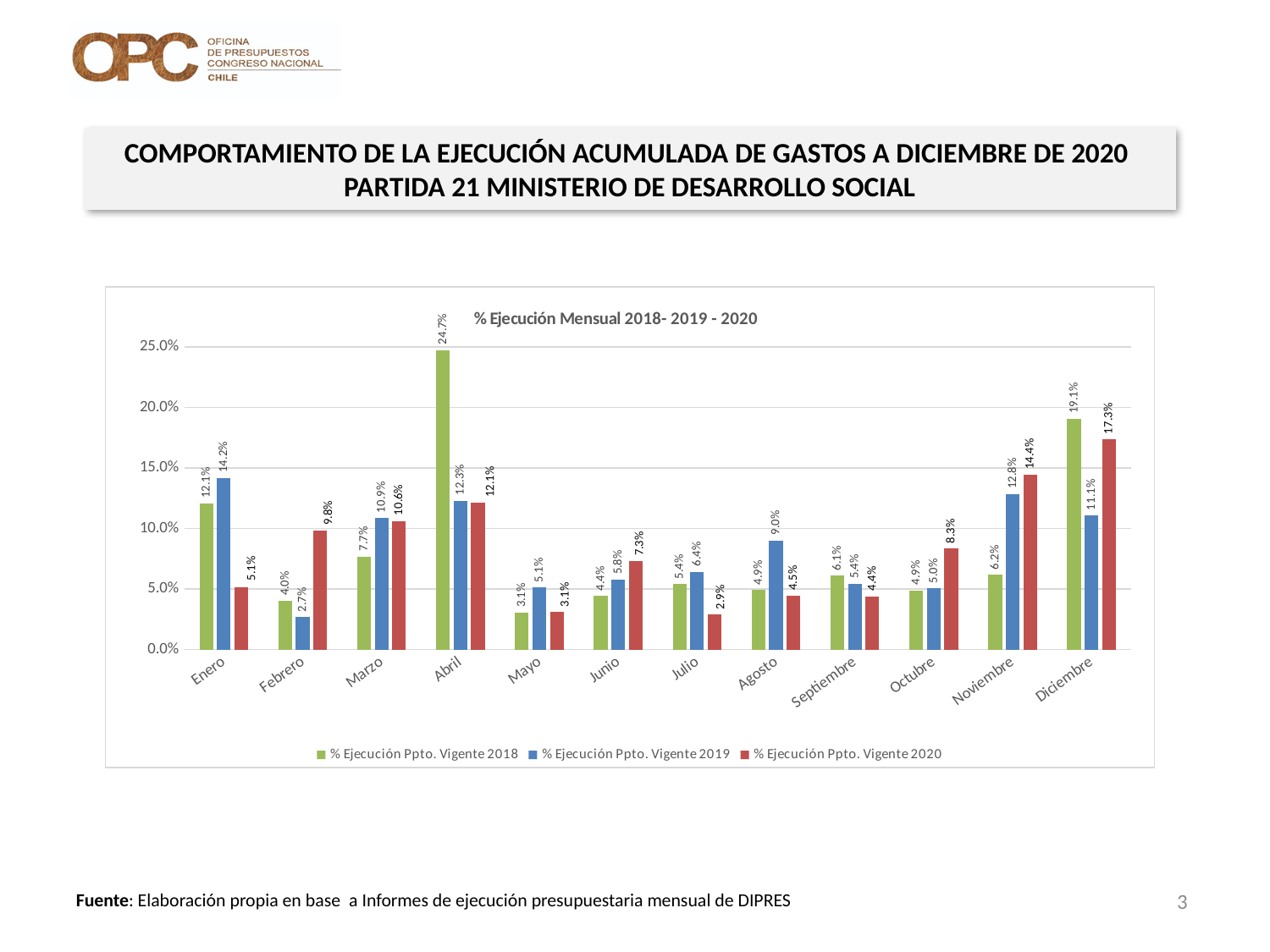
What is the value for % Ejecución Ppto. Vigente 2019 in Noviembre? 12.8% What is the value for % Ejecución Ppto. Vigente 2020 in Diciembre? 17.3% In which month is the % Ejecución Ppto. Vigente 2020 series lowest? Julio Is the value for % Ejecución Ppto. Vigente 2018 in Diciembre greater or less than 15.0%? greater How many months are shown on the x axis? 12 In which month is the % Ejecución Ppto. Vigente 2018 series highest? Abril Which is larger in Enero: the 2019 value or the 2020 value? 2019 value (14.2%) What is the difference between the 2018 and 2019 values in Abril? 12.4% How many series does the legend list? 3 What is the value for % Ejecución Ppto. Vigente 2018 in Abril? 24.7% What is the value for % Ejecución Ppto. Vigente 2020 in Febrero? 9.8% What kind of chart is shown on the slide? Bar chart